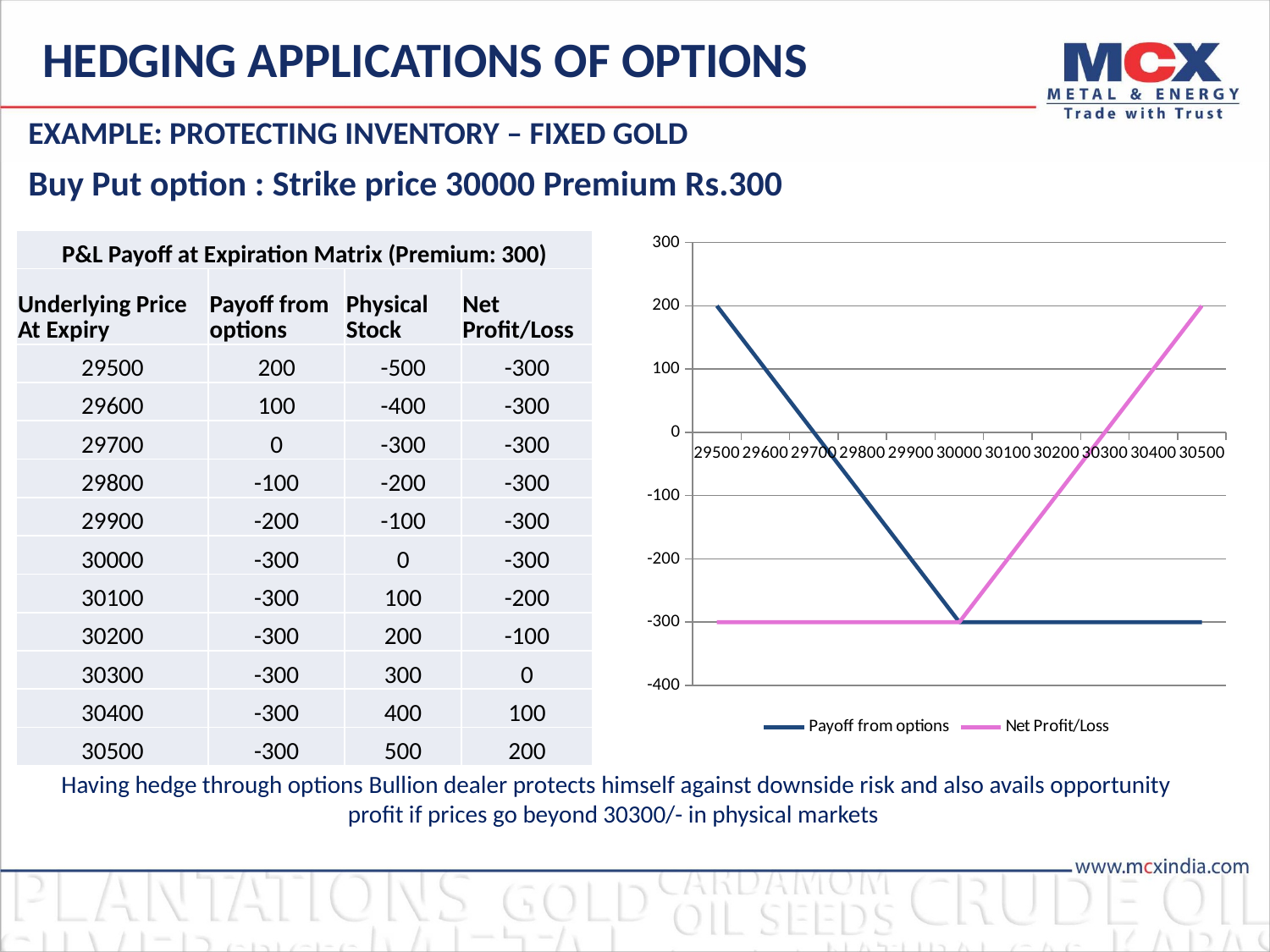
At which underlying price does the Payoff from options line cross zero? 29700 What is the value of Net Profit/Loss at an underlying price of 30500? 200 At an underlying price of 29800, which series has the larger value: Payoff from options or Net Profit/Loss? Payoff from options How many series does the chart legend list? 2 Does the Net Profit/Loss line rise or fall between 30000 and 30500 on the x axis? rise What is the value of Net Profit/Loss at an underlying price of 30000? -300 Does the Payoff from options line rise or fall between 29500 and 30000 on the x axis? fall What are the two series named in the chart legend? Payoff from options; Net Profit/Loss What is the value of Payoff from options at an underlying price of 29500? 200 What kind of chart is shown on the slide? line chart How many underlying price points are plotted along the x axis of the chart? 11 At which underlying price does the Net Profit/Loss line cross zero? 30300